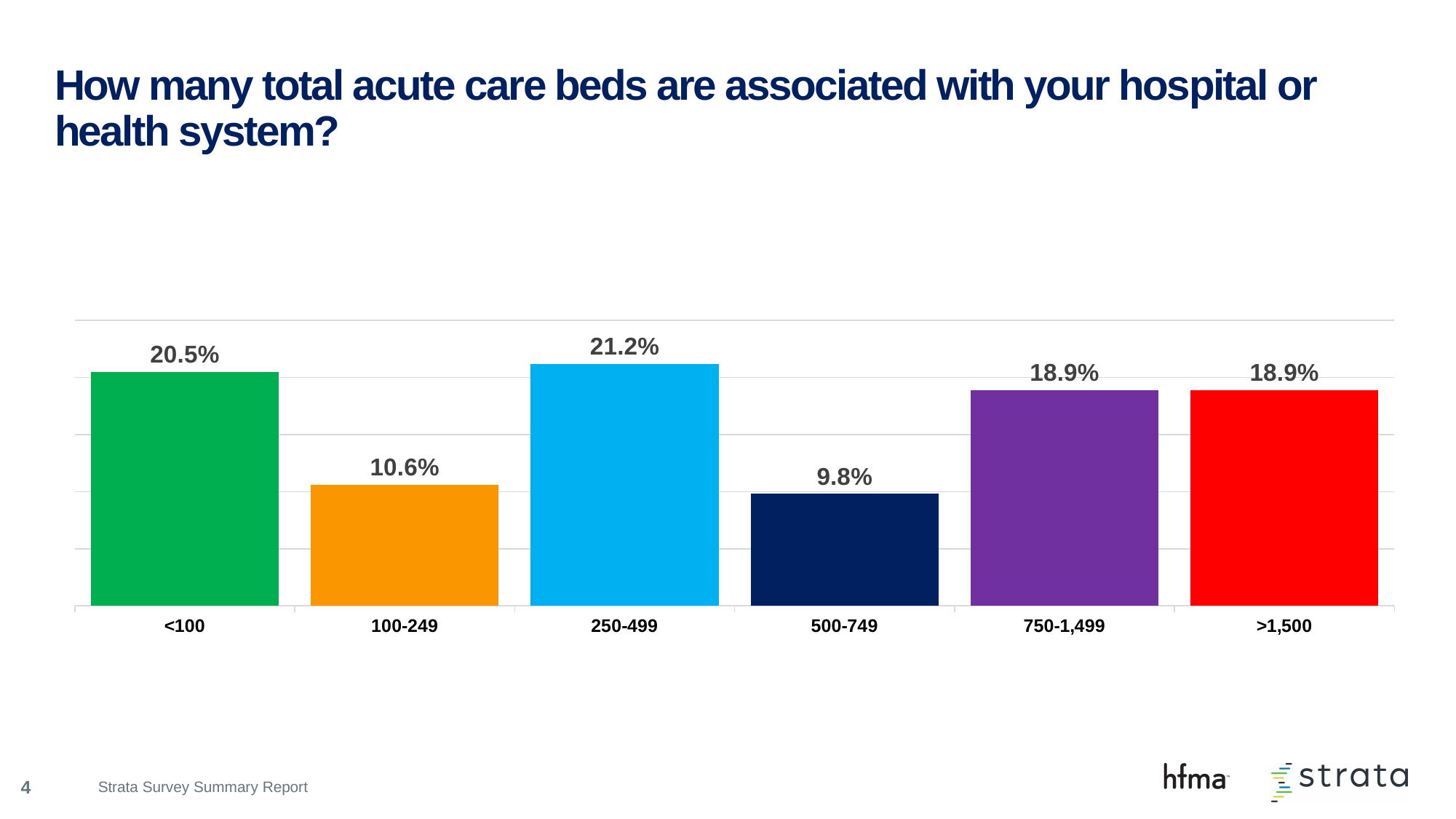
How many bed-count categories are shown in the chart? 6 Which bed-count category has the highest percentage? 250-499 Which is larger, the value for 750-1,499 beds or the value for 100-249 beds? 750-1,499 What percentage of respondents reported fewer than 100 acute care beds (<100)? 20.5% What is the difference between the 250-499 category and the <100 category? 0.7% What type of chart is used on this slide? Bar chart What is the difference between the 100-249 category and the 500-749 category? 0.8% What percentage is shown for the 500-749 beds category? 9.8% What is the value for the >1,500 beds category? 18.9% What is the value shown for the 100-249 beds category? 10.6% What colour is the bar for the 250-499 category? Light blue Which bed-count category has the lowest percentage? 500-749